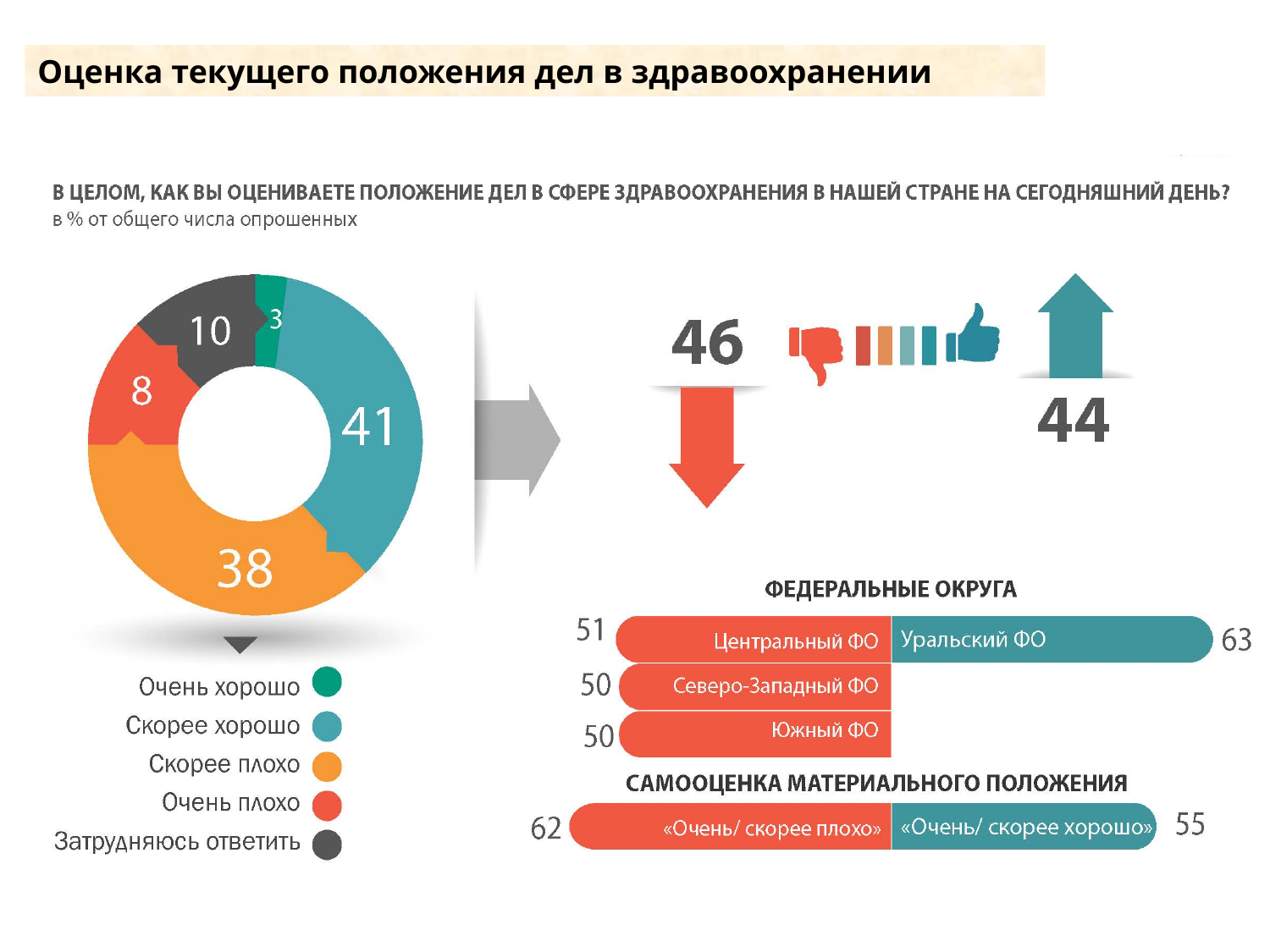
In the donut chart, what percentage of respondents answered «Скорее хорошо»? 41 In the «ФЕДЕРАЛЬНЫЕ ОКРУГА» bar chart, what value is shown for Центральный ФО? 51 In the donut chart, which answer category has the largest share? Скорее хорошо In the «САМООЦЕНКА МАТЕРИАЛЬНОГО ПОЛОЖЕНИЯ» bar chart, which value is larger: «Очень/ скорее плохо» or «Очень/ скорее хорошо»? «Очень/ скорее плохо» In the «САМООЦЕНКА МАТЕРИАЛЬНОГО ПОЛОЖЕНИЯ» bar chart, what is the difference between the «Очень/ скорее плохо» and «Очень/ скорее хорошо» values? 7 In the donut chart, what percentage of respondents answered «Скорее плохо»? 38 In the «ФЕДЕРАЛЬНЫЕ ОКРУГА» bar chart, what value is shown for Уральский ФО? 63 In the donut chart, which answer category has the smallest share? Очень хорошо In the donut chart, what is the difference between the «Очень плохо» and «Очень хорошо» values? 5 How many answer categories does the donut chart's legend list? 5 What type of chart is used on the left side of the slide to show the answer distribution? Donut (pie) chart In the donut chart, what value is shown for «Затрудняюсь ответить»? 10